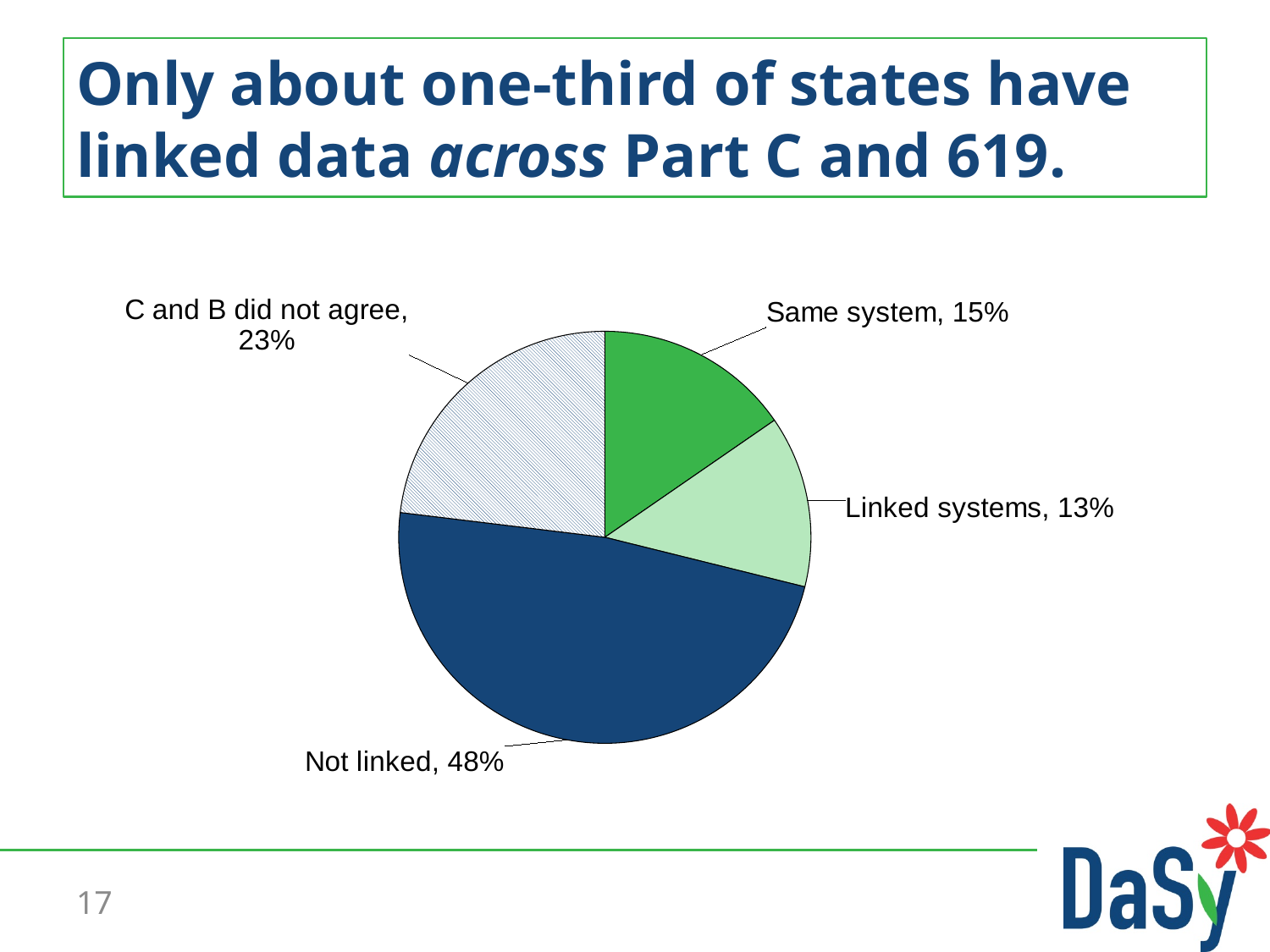
How many slices does the pie chart have? 4 What percentage of states have 'Linked systems'? 13% What kind of chart is shown on the slide? pie chart Which category has the largest share of the pie? Not linked Which slice of the pie is drawn with a hatched pattern? C and B did not agree What percentage of states are in the 'Same system' category? 15% Which is larger, the share for 'Same system' or the share for 'Linked systems'? Same system What percentage of states are in the 'C and B did not agree' category? 23% What is the difference in percentage points between 'Not linked' and 'C and B did not agree'? 25 Which category has the smallest share of the pie? Linked systems What is the combined share of 'Same system' and 'Linked systems'? 28% What percentage of states are in the 'Not linked' category? 48%